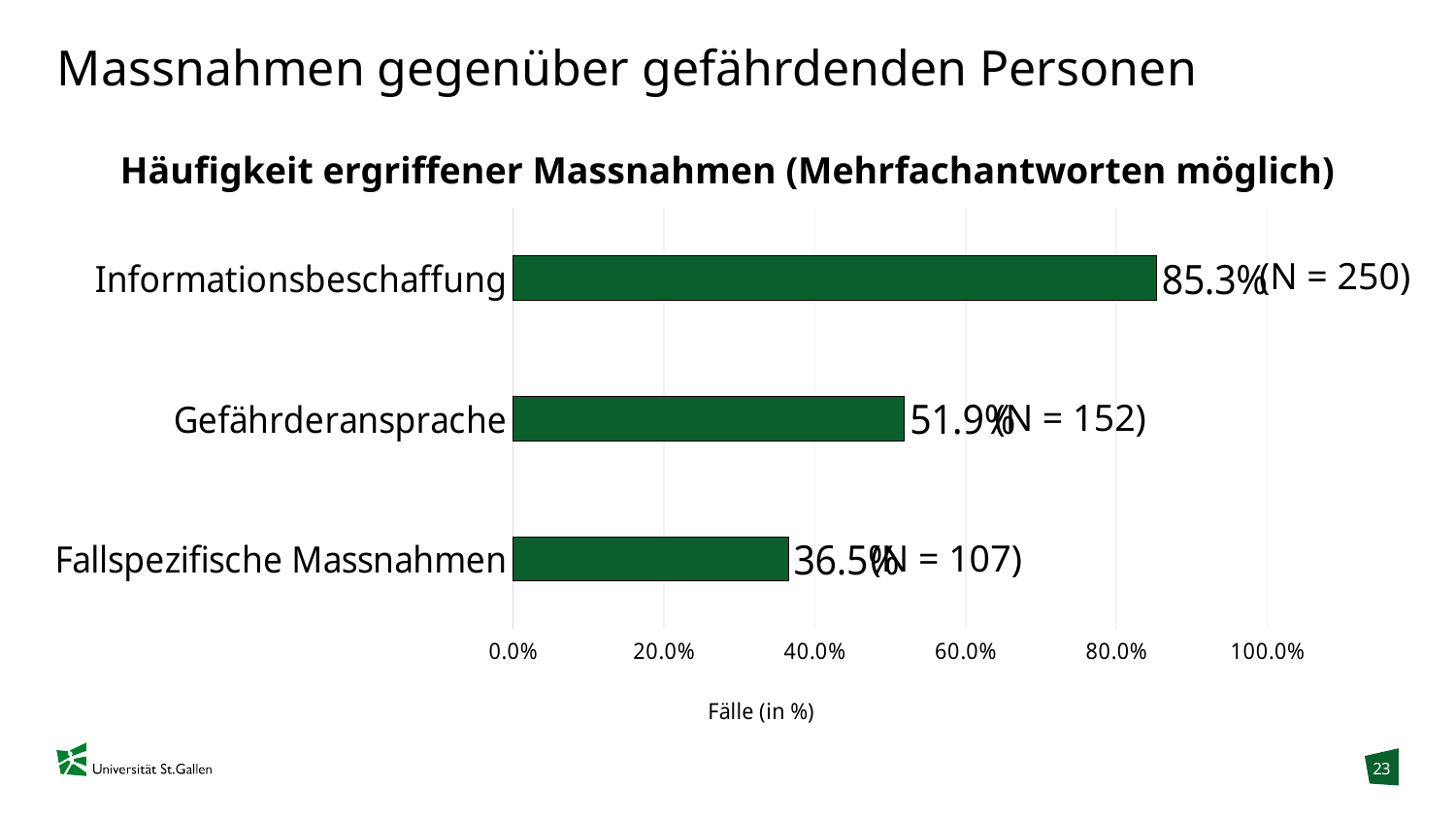
Which has a larger percentage of cases, Gefährderansprache or Fallspezifische Massnahmen? Gefährderansprache What type of chart is shown on the slide? Bar chart What is the difference in percentage points between Gefährderansprache and Fallspezifische Massnahmen? 15.4 percentage points Which measure has the lowest percentage of cases? Fallspezifische Massnahmen What percentage of cases is shown for Fallspezifische Massnahmen? 36.5% What percentage of cases is shown for Informationsbeschaffung? 85.3% What is the difference in percentage points between Informationsbeschaffung and Gefährderansprache? 33.4 percentage points How many measures (categories) are shown in the chart? 3 What is the N value given for Gefährderansprache? N = 152 What is the label of the horizontal axis of the chart? Fälle (in %) What percentage of cases is shown for Gefährderansprache? 51.9% Which measure has the highest percentage of cases? Informationsbeschaffung